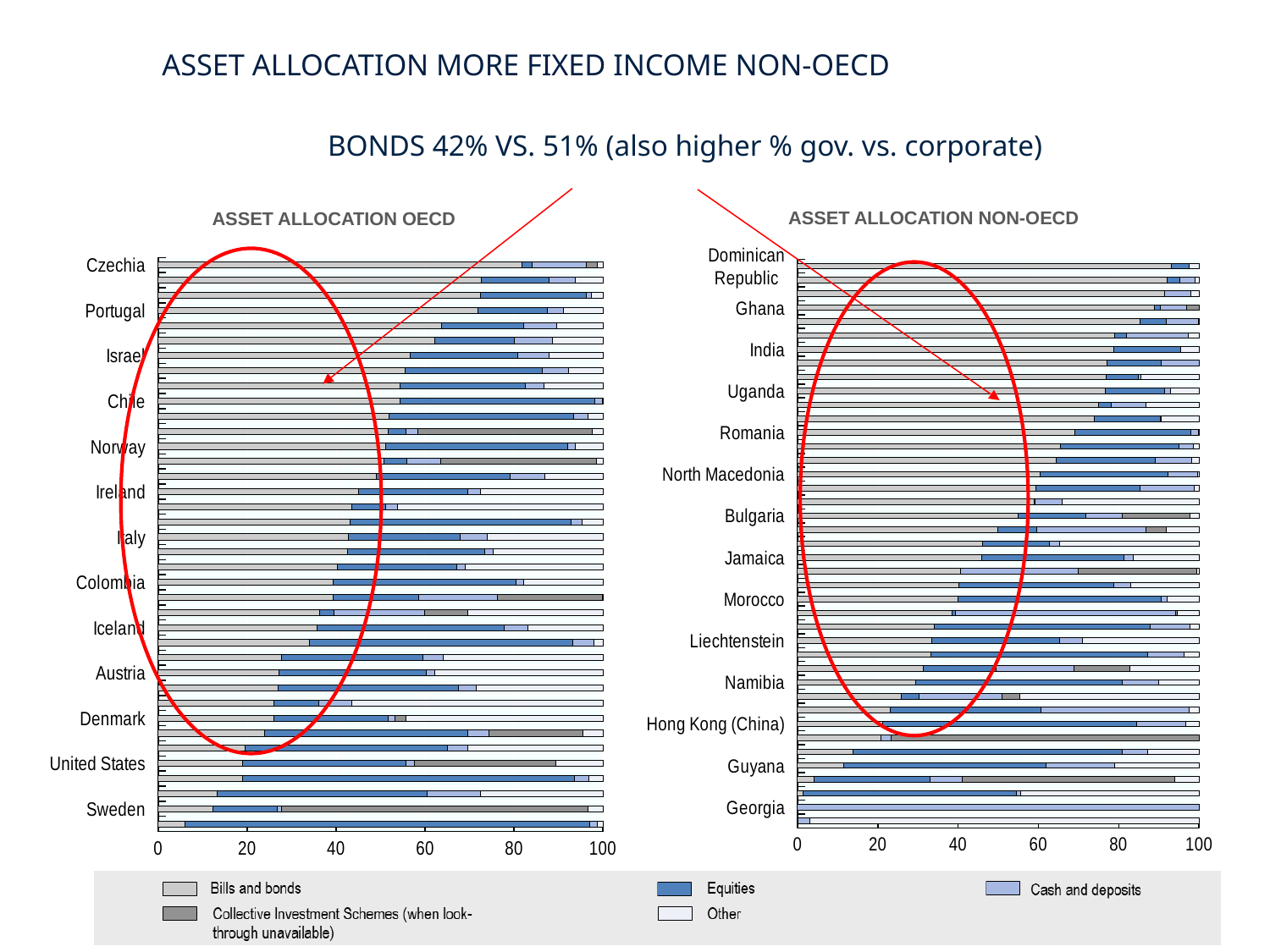
How many series does the legend list for the asset allocation charts? 5 What is the title of the chart on the right side of the slide? ASSET ALLOCATION NON-OECD In the ASSET ALLOCATION OECD chart, which has the larger Bills and bonds value, Czechia or Sweden? Czechia Which series is shown in the lightest grey colour in the legend? Bills and bonds What type of chart is the ASSET ALLOCATION OECD chart? Stacked bar chart In the ASSET ALLOCATION OECD chart, does the Bills and bonds share increase or decrease going from the top country to the bottom country? decrease In the ASSET ALLOCATION NON-OECD chart, is the Bills and bonds value for Ghana greater or less than 60? greater In the ASSET ALLOCATION OECD chart, is the Bills and bonds value for United States greater or less than 40? less In the ASSET ALLOCATION OECD chart, is the Bills and bonds value for Czechia greater or less than 60? greater What is the maximum value shown on the x axis of the ASSET ALLOCATION NON-OECD chart? 100